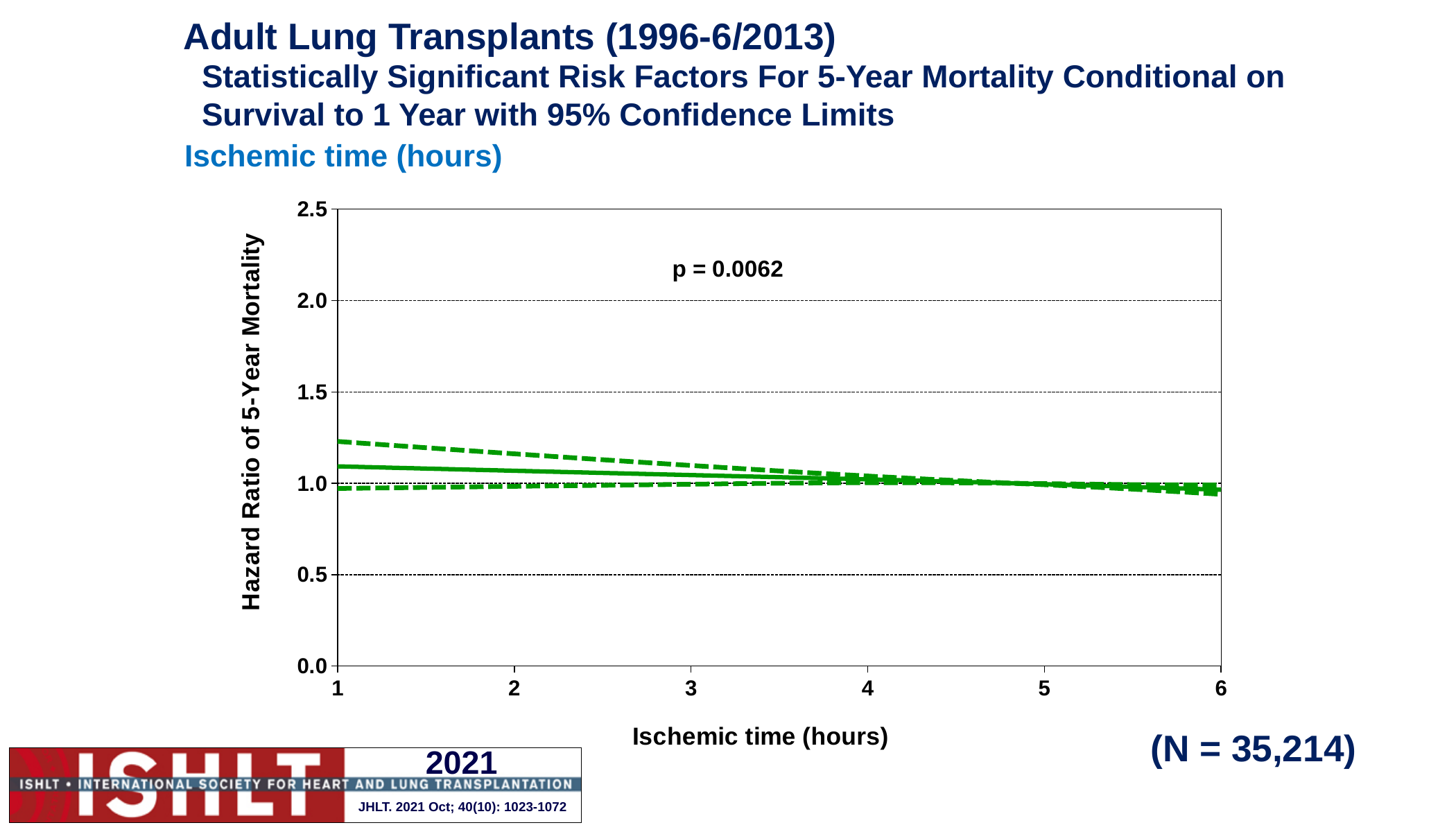
Is the hazard ratio on the solid line at 1 hour of ischemic time greater or less than 1.0? greater Is the upper dashed confidence limit at 1 hour of ischemic time greater or less than 1.5? less Is the hazard ratio on the solid line at 3 hours of ischemic time greater or less than 0.5? greater What kind of chart is shown on the slide? line chart At which ischemic time shown on the x axis is the solid hazard ratio line highest? 1 hour What sample size (N) is shown on the slide? N = 35,214 Is the solid-line hazard ratio larger at 1 hour or at 6 hours of ischemic time? 1 hour How many tick values are labelled on the x axis of the chart? 6 What p-value is printed on the chart? p = 0.0062 Does the solid hazard ratio line rise or fall as ischemic time increases from 1 to 6 hours? fall How many lines are plotted on the chart? 3 At 1 hour of ischemic time, which is larger: the upper dashed confidence limit or the lower dashed confidence limit? upper dashed confidence limit